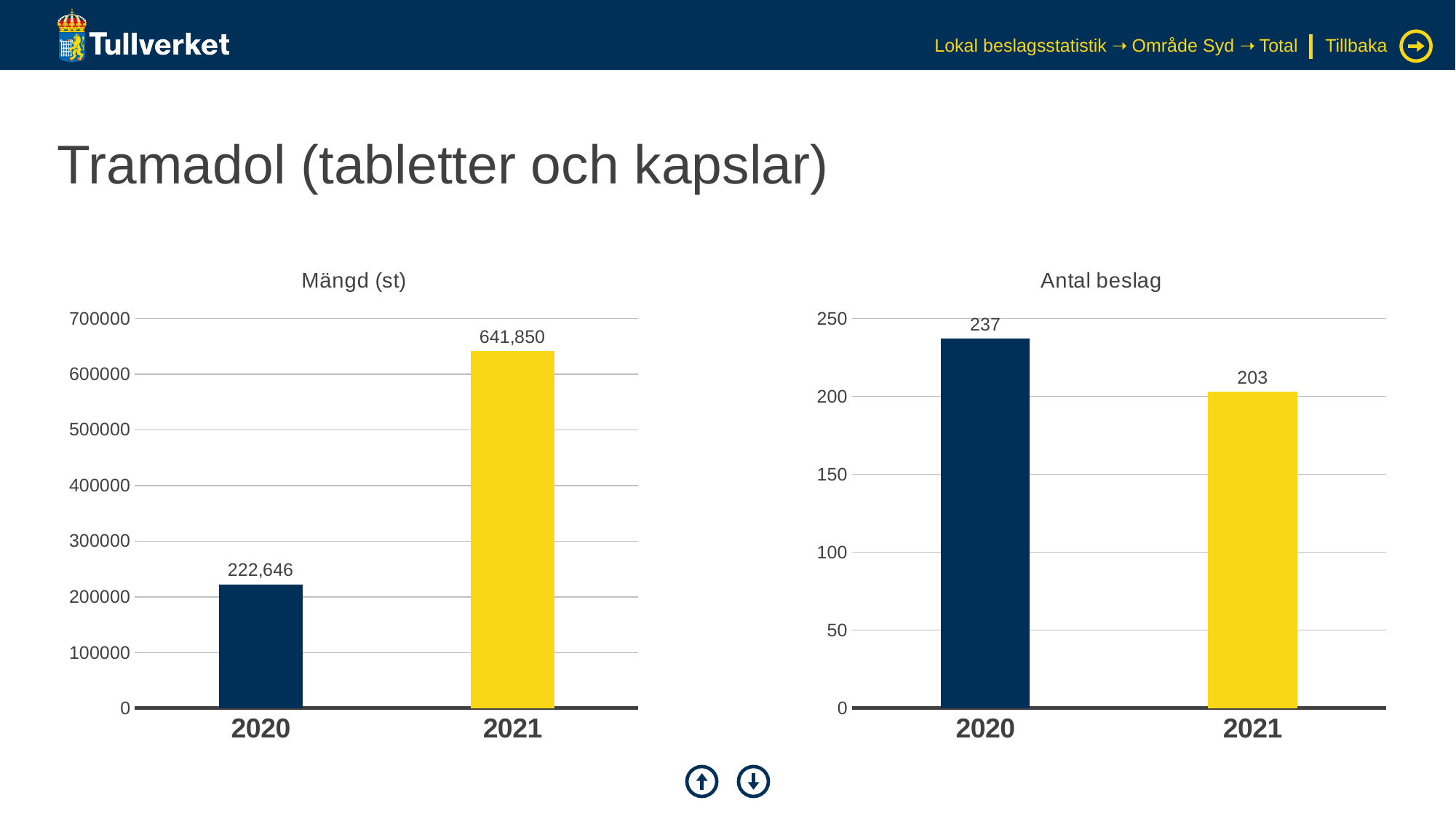
In the "Antal beslag" chart, do the values rise or fall from 2020 to 2021? Fall What kind of chart is the "Antal beslag" chart? Bar chart In the "Antal beslag" chart, what is the difference between the 2020 and 2021 values? 34 In the "Antal beslag" chart, which year has the lower value? 2021 In the "Antal beslag" chart, is the value for 2020 greater or less than 200? greater In the "Antal beslag" chart, what is the value for 2021? 203 In the "Mängd (st)" chart, which year has the higher value? 2021 In the "Mängd (st)" chart, what is the value for 2020? 222,646 How many years are shown in the "Mängd (st)" chart? 2 In the "Mängd (st)" chart, what is the difference between the 2021 and 2020 values? 419,204 In the "Mängd (st)" chart, what is the value for 2021? 641,850 In the "Antal beslag" chart, what is the value for 2020? 237